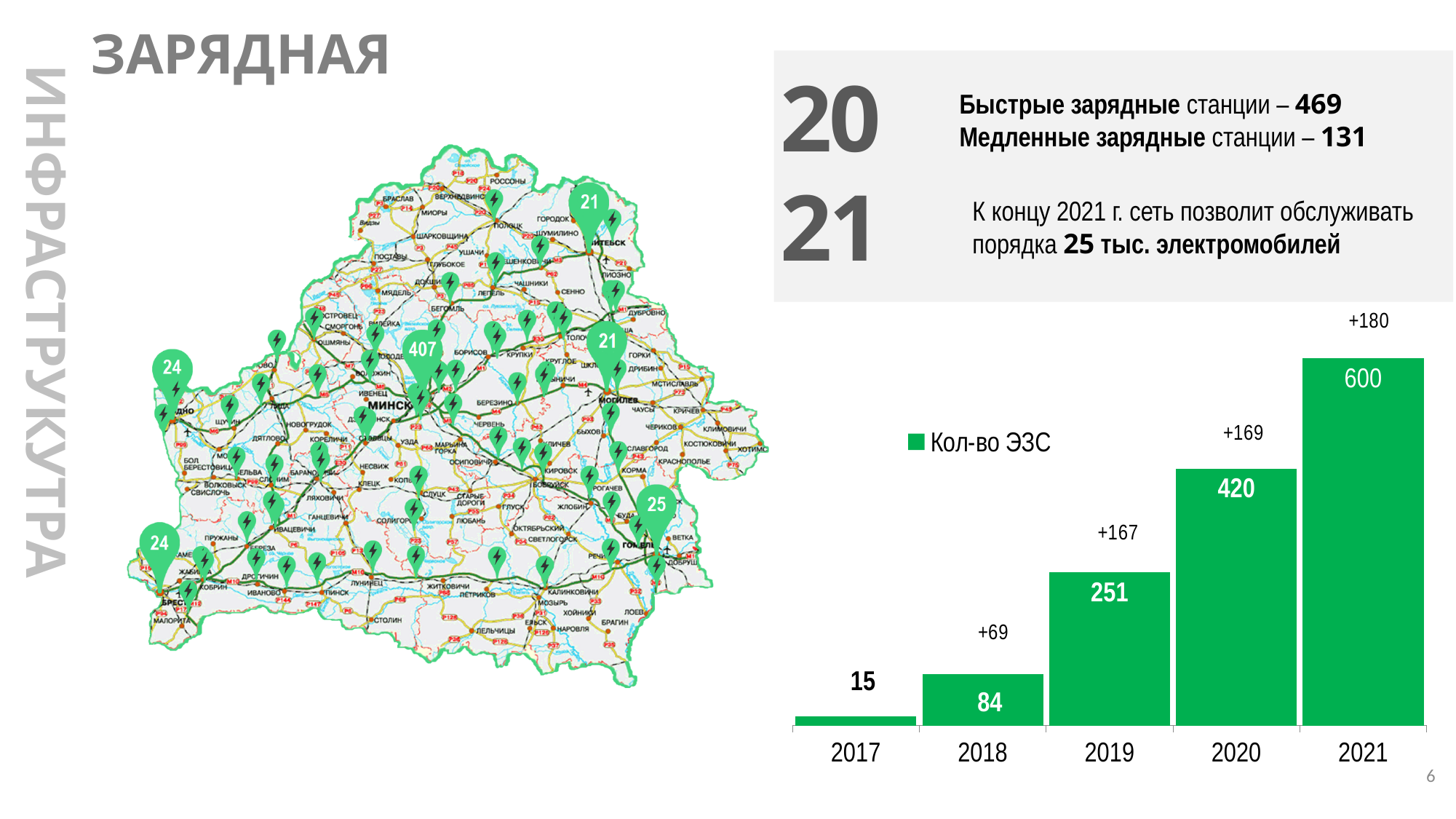
What is the difference between the values for 2021 and 2017 in the bar chart? 585 Which year has the lowest value in the bar chart? 2017 What is the value for 2017 in the bar chart? 15 What series name does the legend of the bar chart show? Кол-во ЭЗС What type of chart is shown on the right side of the slide? bar chart What is the difference between the values for 2020 and 2019 in the bar chart? 169 Which is larger in the bar chart, the value for 2018 or the value for 2020? 2020 What is the value for 2021 in the bar chart? 600 How many years are shown on the x axis of the bar chart? 5 Which year has the highest value in the bar chart? 2021 Do the values in the bar chart rise or fall from 2017 to 2021? rise What is the value for 2019 in the bar chart? 251